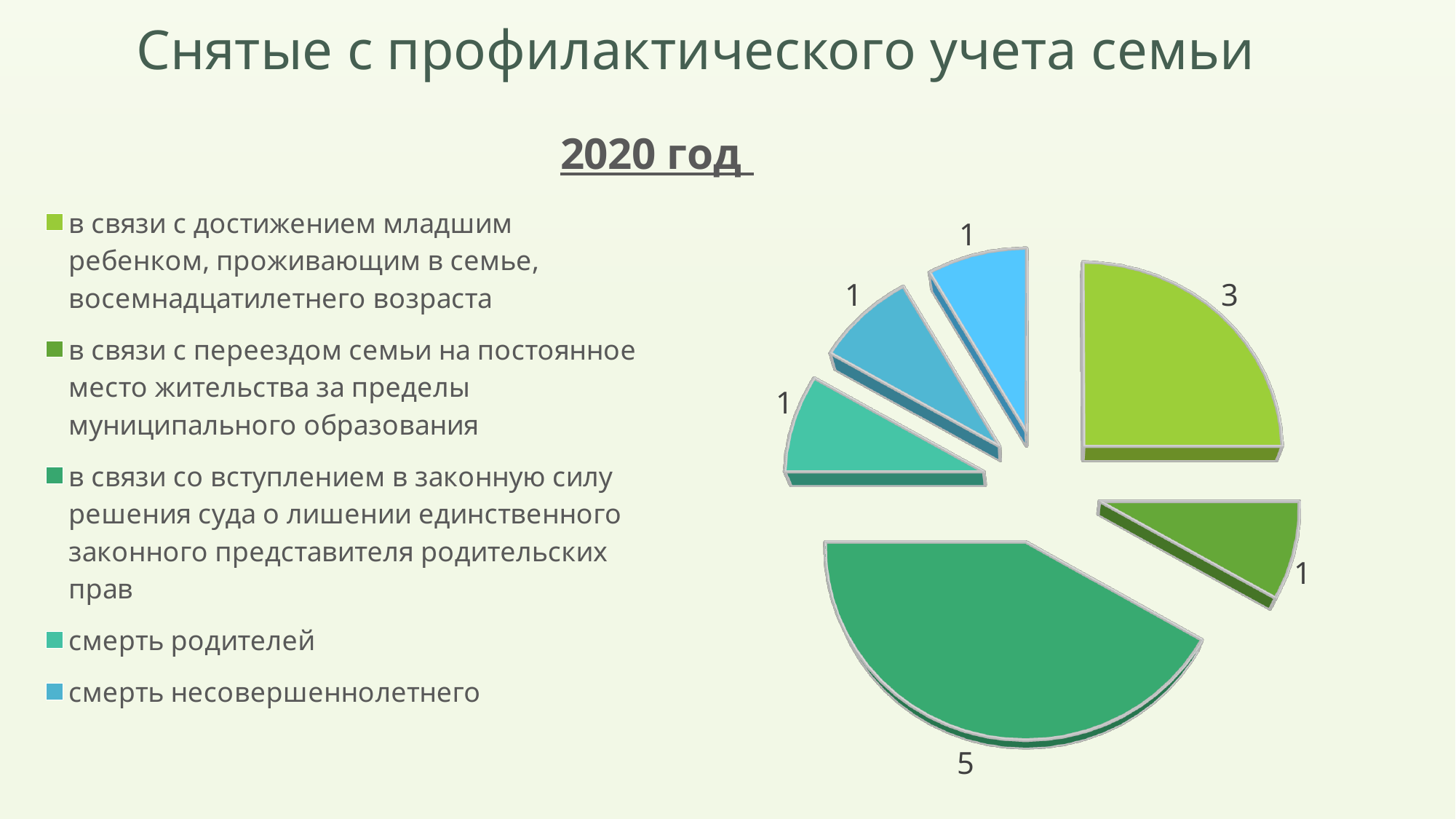
Which is larger: the value for "в связи с достижением младшим ребенком, проживающим в семье, восемнадцатилетнего возраста" or the value for "смерть родителей"? в связи с достижением младшим ребенком, проживающим в семье, восемнадцатилетнего возраста What is the value for the slice "в связи со вступлением в законную силу решения суда о лишении единственного законного представителя родительских прав"? 5 What is the value for the slice "в связи с переездом семьи на постоянное место жительства за пределы муниципального образования"? 1 How many entries does the legend list? 5 What is the value for the slice "в связи с достижением младшим ребенком, проживающим в семье, восемнадцатилетнего возраста"? 3 How many slices does the pie chart have? 6 What is the difference between the largest slice value and the value for "в связи с достижением младшим ребенком, проживающим в семье, восемнадцатилетнего возраста"? 2 What is the value for the slice "смерть родителей"? 1 What kind of chart is shown on the slide? pie chart What is the value for the slice "смерть несовершеннолетнего"? 1 What year is shown as the subtitle above the chart? 2020 год Which category has the largest slice of the pie? в связи со вступлением в законную силу решения суда о лишении единственного законного представителя родительских прав